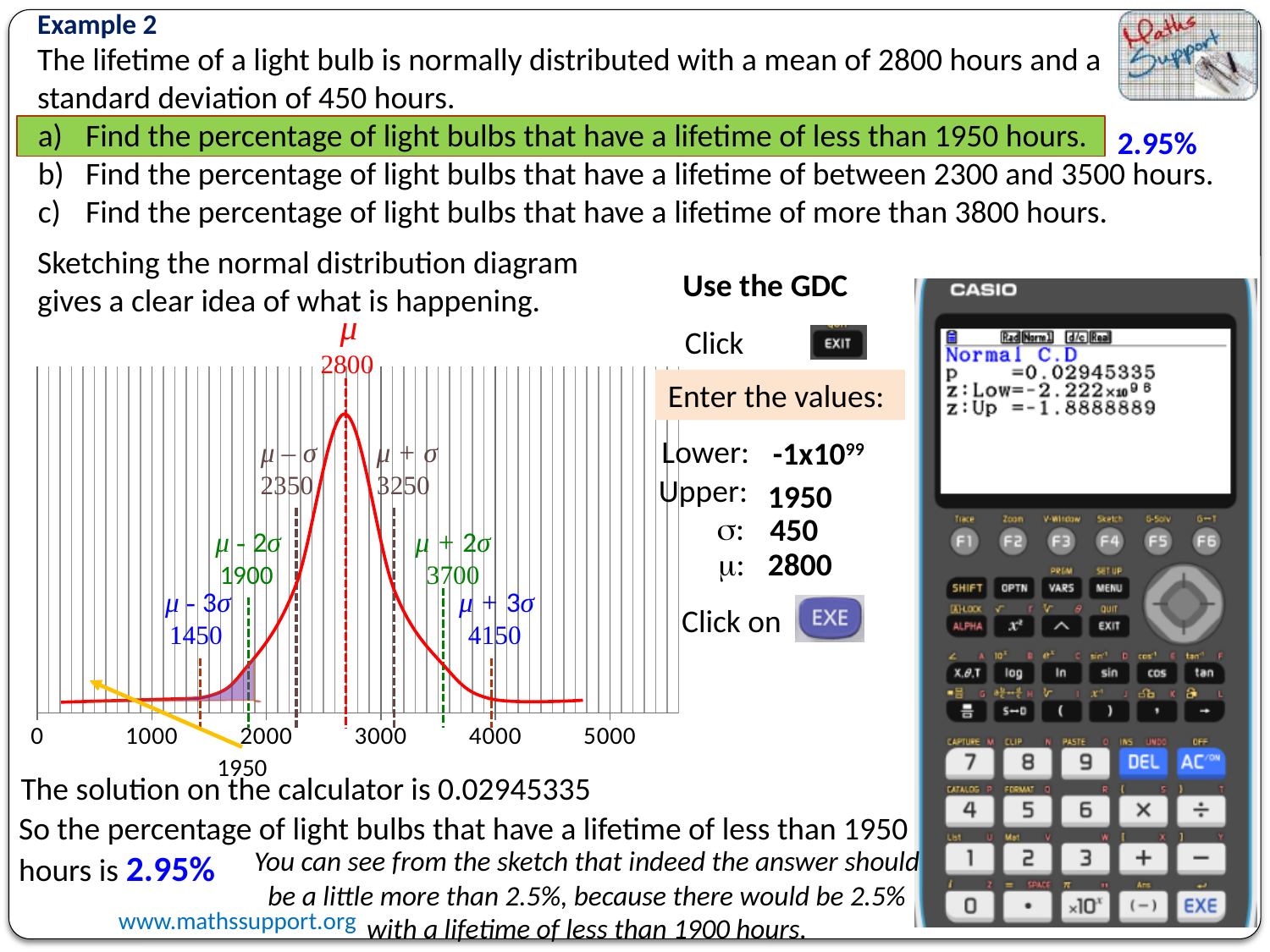
What value is labelled at the mean (μ) on the normal distribution sketch? 2800 How many numbered tick labels are shown on the x axis of the sketch? 6 What colour is the normal distribution curve drawn in? red Which is larger on the sketch, the value labelled at μ − 2σ or the value labelled at μ − 3σ? μ − 2σ What value is labelled at μ − σ on the normal distribution sketch? 2350 What is the difference between the values labelled at μ + 3σ and μ − 3σ on the sketch? 2700 What is the difference between the values labelled at μ + σ and μ − σ on the sketch? 900 What value is labelled at μ + 2σ on the normal distribution sketch? 3700 Is the x-value at the peak of the curve greater or less than 2000? greater What kind of chart is the normal distribution sketch? line chart What value is labelled at μ + 3σ on the normal distribution sketch? 4150 What value is labelled at μ − 3σ on the normal distribution sketch? 1450